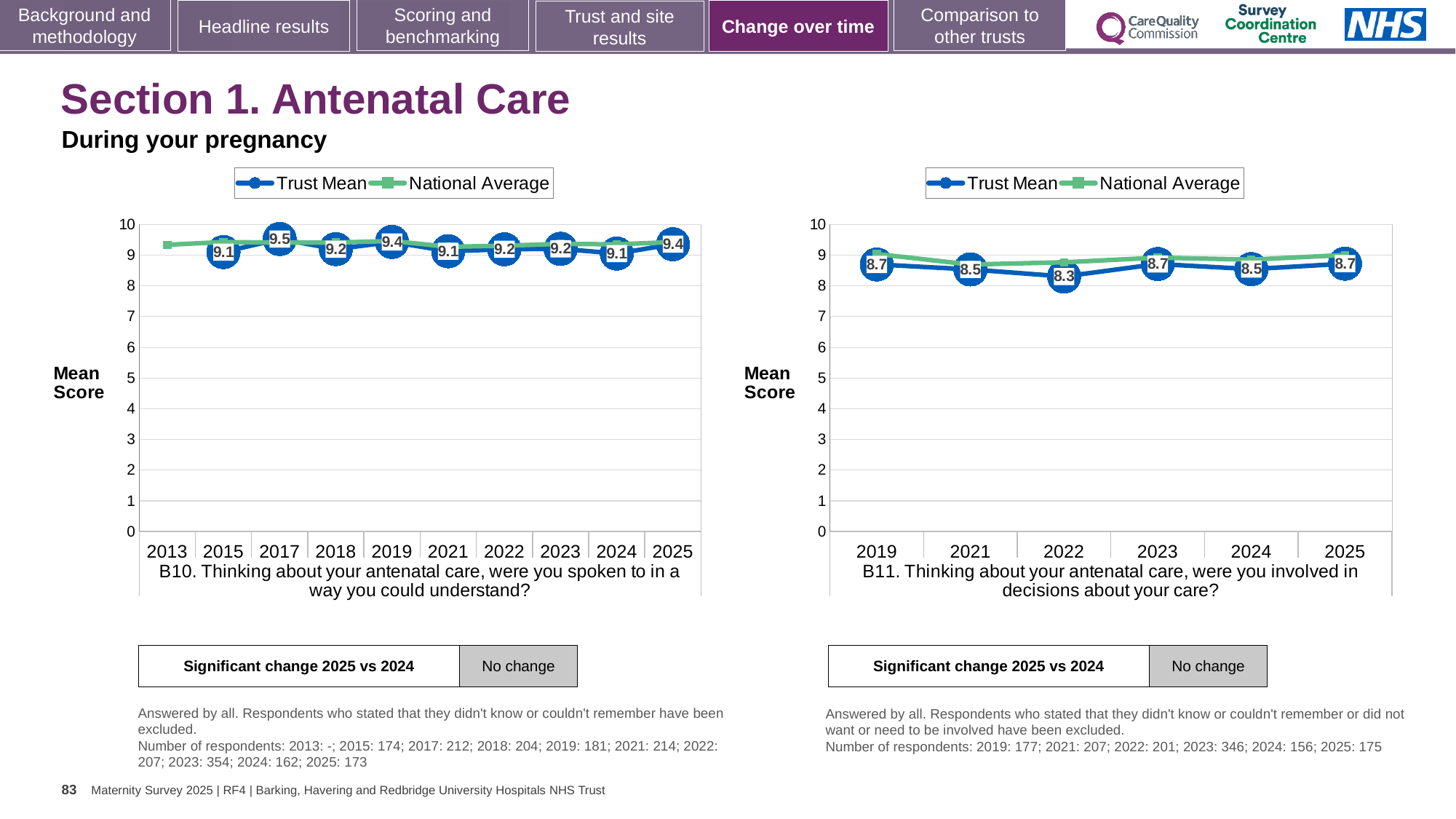
On the right chart (B11), what is the label of the y axis? Mean Score On the right chart (B11), how many series does the legend list? 2 On the right chart (B11), what is the Trust Mean for 2022? 8.3 On the left chart (B10), which is larger, the Trust Mean for 2019 or for 2021? 2019 On the left chart (B10), what is the Trust Mean for 2025? 9.4 On the right chart (B11), what is the difference between the Trust Mean in 2023 and in 2022? 0.4 On the left chart (B10), in which year is the Trust Mean highest? 2017 On the right chart (B11), in which year is the Trust Mean lowest? 2022 What type of chart is the right chart (B11)? Line chart On the left chart (B10), what is the Trust Mean for 2017? 9.5 On the left chart (B10), how many years are shown on the x axis? 10 On the right chart (B11), what is the Trust Mean for 2025? 8.7